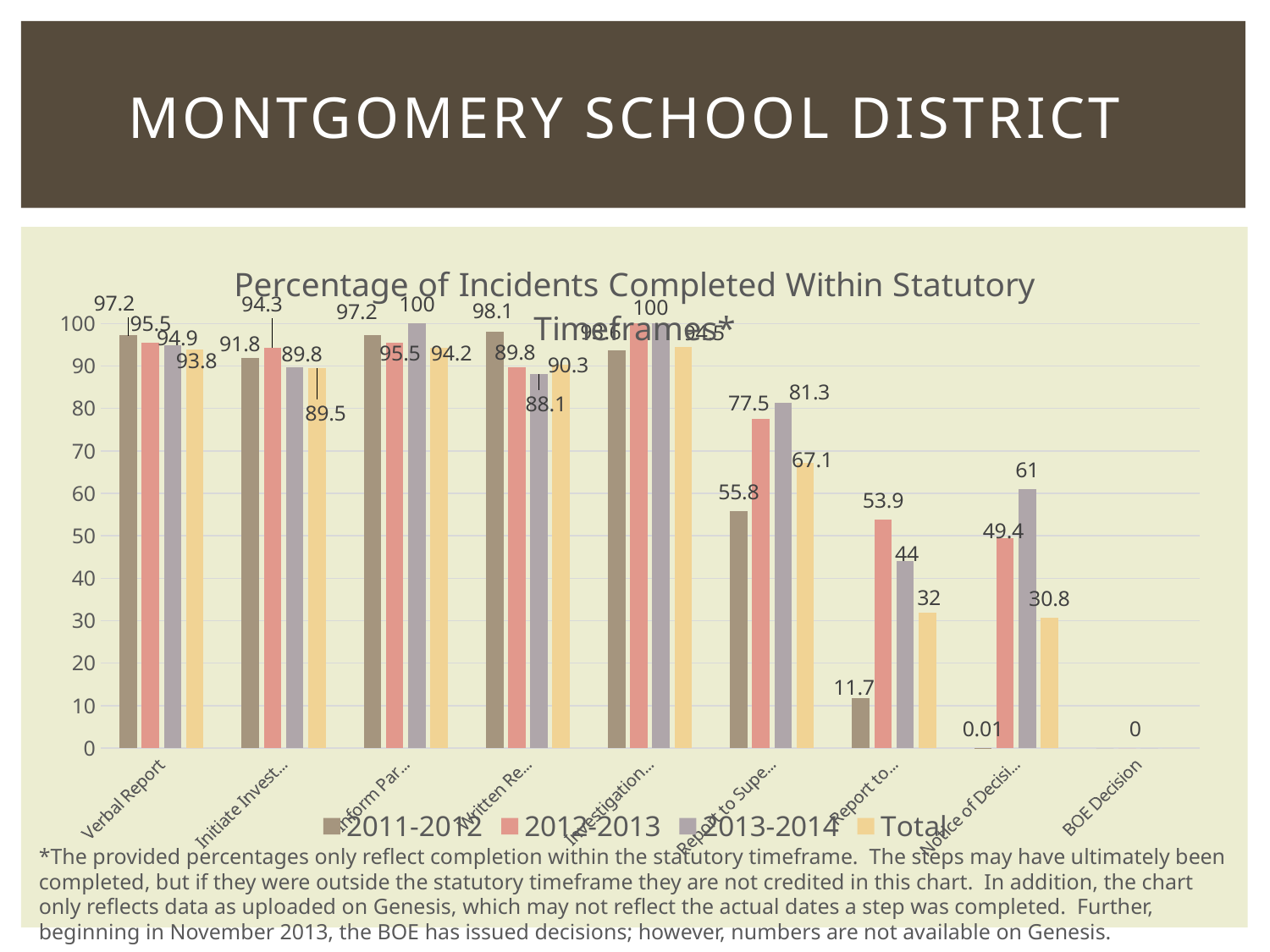
How many series does the legend list? 4 Is the 2011-2012 value for the category labelled 'Report to Supe...' greater or less than 60? less What is the 2013-2014 value for the category labelled 'Notice of Decisi...'? 61 What is the 2011-2012 value for Verbal Report? 97.2 What is the title of the chart? Percentage of Incidents Completed Within Statutory Timeframes* What value is labelled for BOE Decision? 0 How many categories are shown along the x axis? 9 What is the Total value for Verbal Report? 93.8 Which series has the highest value for Verbal Report? 2011-2012 For Verbal Report, which is larger: the 2012-2013 value or the 2013-2014 value? 2012-2013 What kind of chart is shown on the slide? bar chart What is the difference between the 2011-2012 value and the Total value for Verbal Report? 3.4